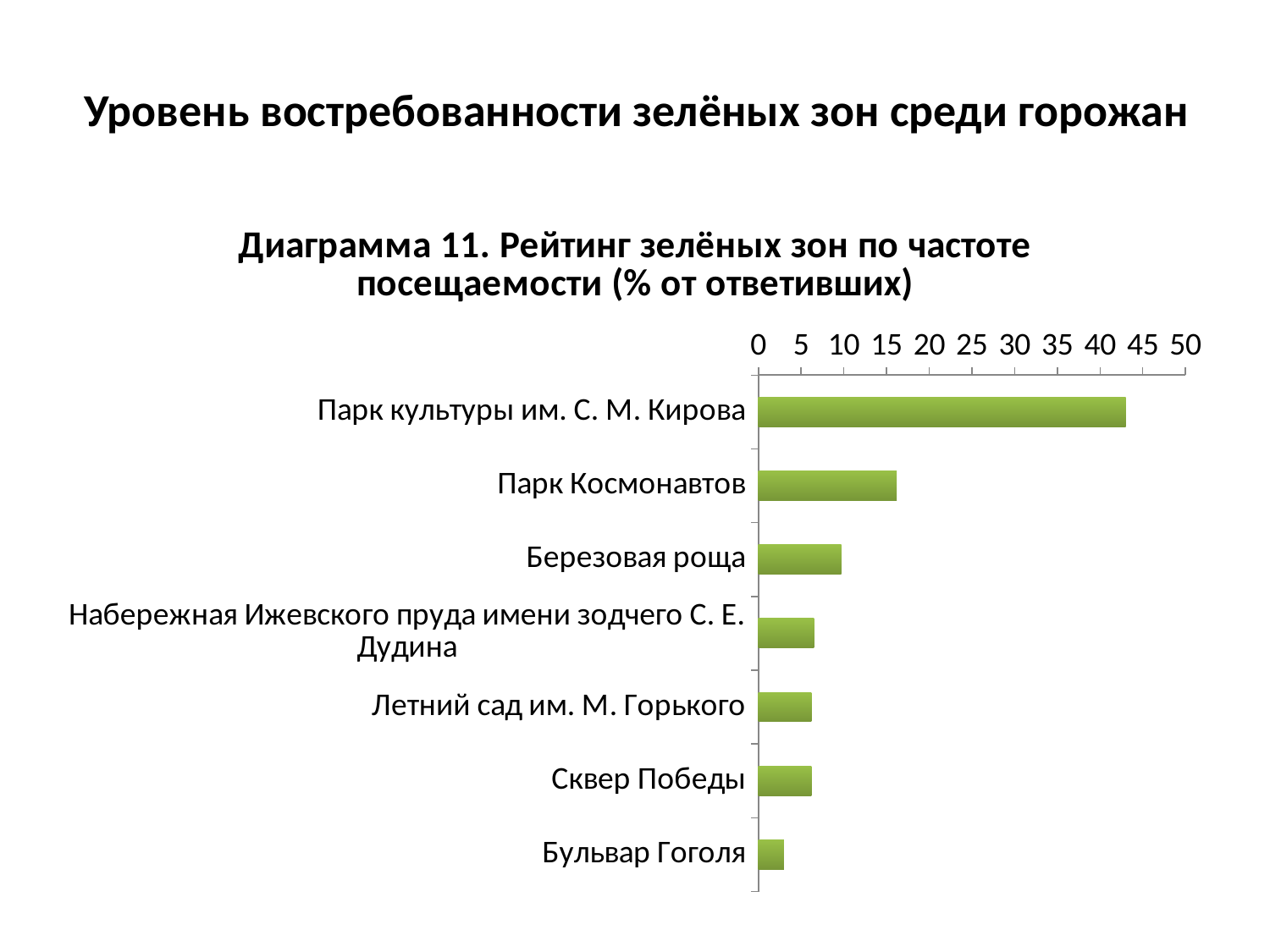
Which has a higher value: Парк культуры им. С. М. Кирова or Парк Космонавтов? Парк культуры им. С. М. Кирова Which has a higher value: Березовая роща or Бульвар Гоголя? Березовая роща Which green zone has the lowest visit frequency in the chart? Бульвар Гоголя Is the value for Березовая роща greater or less than 15? less How many green zones (categories) are listed in the chart? 7 Is the value for Парк Космонавтов greater or less than 20? less What is the title of the chart? Диаграмма 11. Рейтинг зелёных зон по частоте посещаемости (% от ответивших) Is the value for Набережная Ижевского пруда имени зодчего С. Е. Дудина greater or less than 5? greater Which green zone has the highest visit frequency in the chart? Парк культуры им. С. М. Кирова What kind of chart is shown on the slide? bar chart